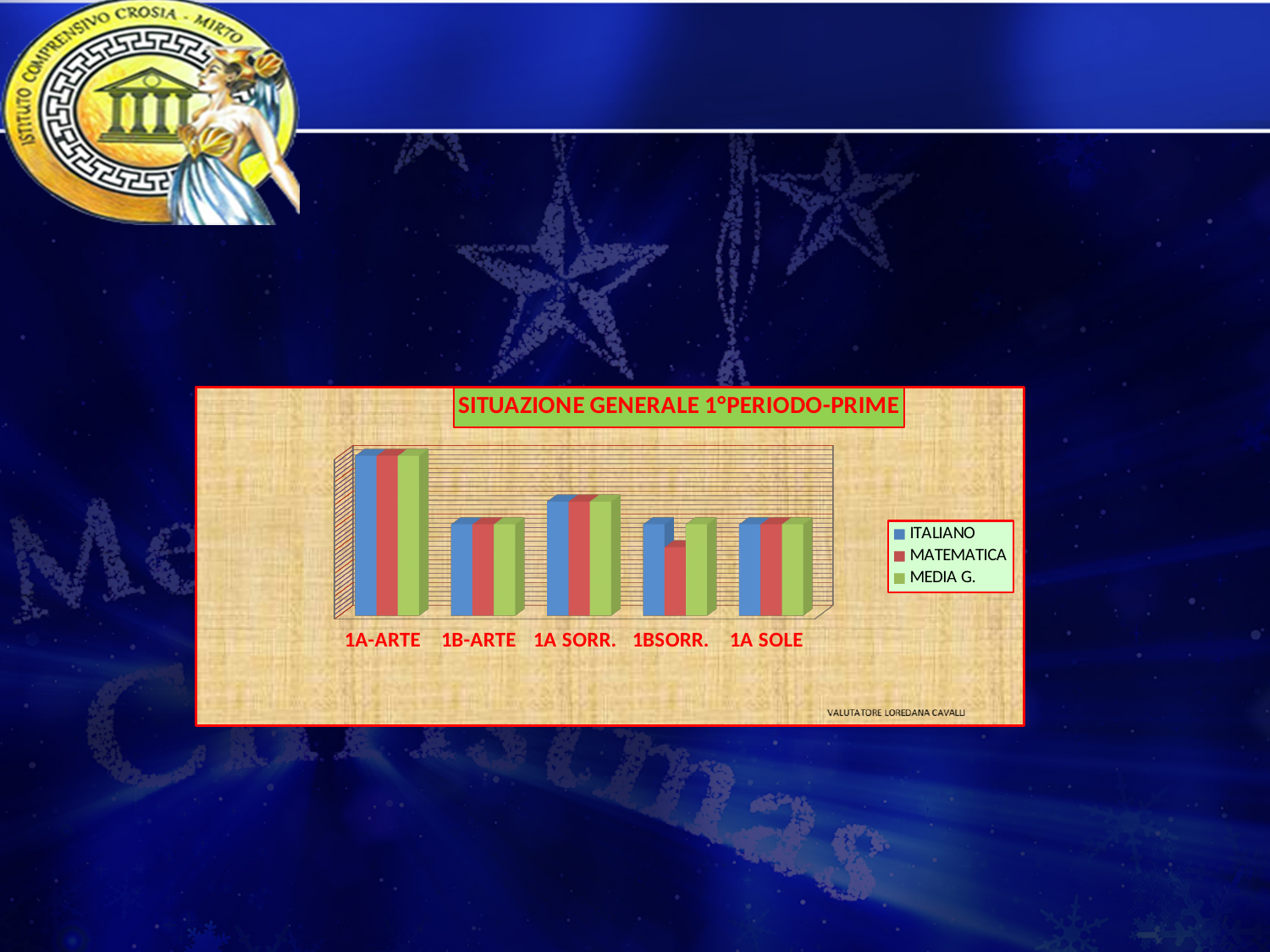
Which category has the highest MATEMATICA value? 1A-ARTE Which is larger, the MATEMATICA value for 1A SORR. or for 1BSORR.? 1A SORR. Does the ITALIANO value rise or fall from 1A-ARTE to 1B-ARTE? fall How many series does the legend list? 3 Which category has the lowest MATEMATICA value? 1BSORR. Which series are listed in the legend? ITALIANO, MATEMATICA, MEDIA G. Which is larger, the ITALIANO value for 1A-ARTE or for 1B-ARTE? 1A-ARTE How many categories are shown on the x axis? 5 What is the title of the chart? SITUAZIONE GENERALE 1°PERIODO-PRIME Which category has the highest MEDIA G. value? 1A-ARTE What kind of chart is shown on the slide? bar chart Which category has the highest ITALIANO value? 1A-ARTE